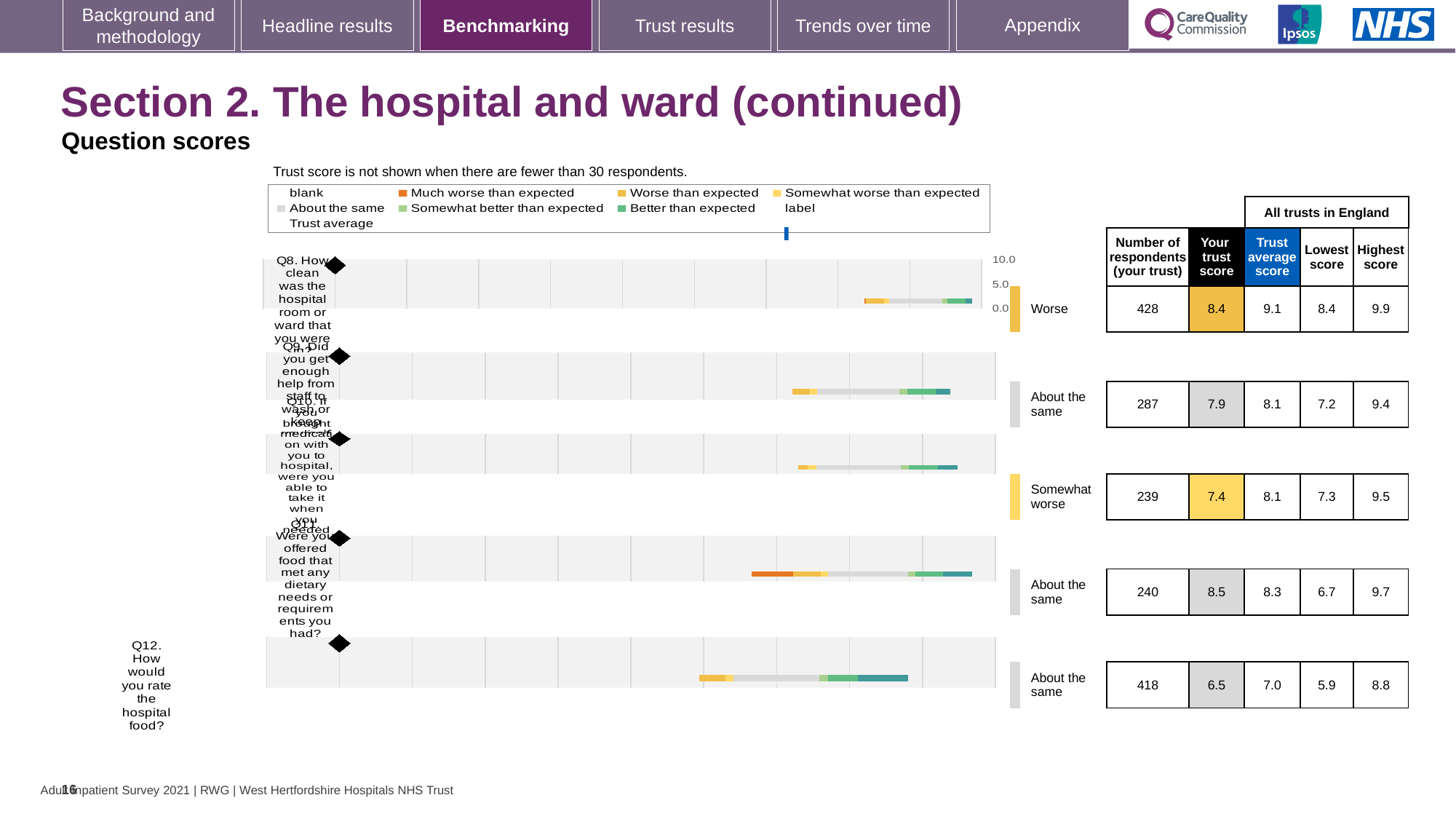
What is the trust score for Q8 (how clean was the hospital room or ward)? 8.4 What benchmark category label is shown next to Q10's bar? Somewhat worse How many respondents answered Q8 for this trust? 428 For Q9, which is larger: the trust's own score or the trust average score? Trust average score What kind of chart is used to show the question scores on this slide? bar chart What is the trust score for Q12 (how would you rate the hospital food)? 6.5 Which question has the lowest 'Your trust score'? Q12 What is the trust average score for Q9? 8.1 How many questions (categories) are plotted in the question scores chart? 5 Which question has the highest 'Your trust score'? Q11 For Q8, what is the difference between the highest score and the lowest score across all trusts in England? 1.5 What is the lowest score across all trusts in England for Q11? 6.7